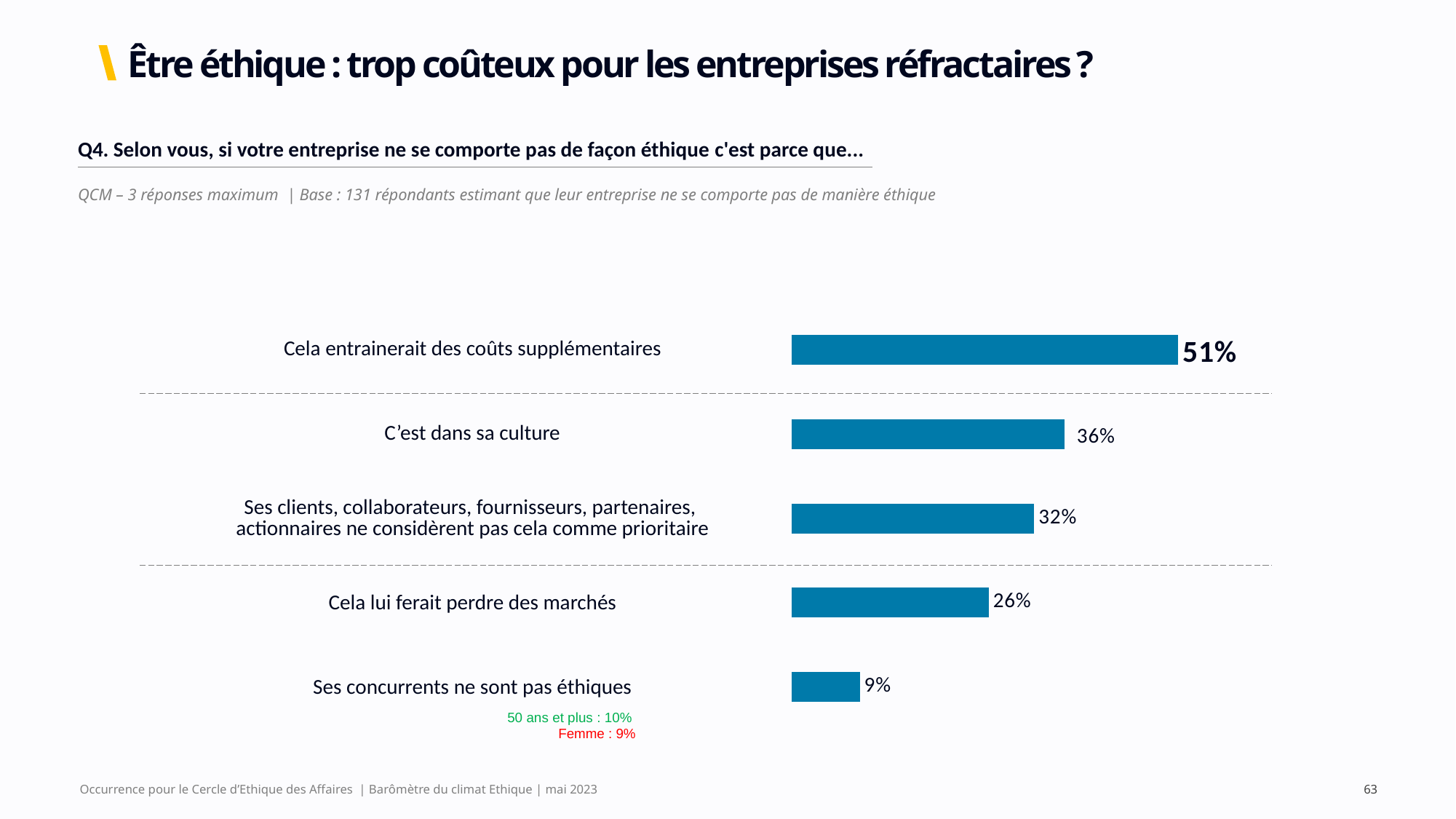
What is the difference between the values for "Cela entrainerait des coûts supplémentaires" and "C'est dans sa culture"? 15% Which is larger: the value for "C'est dans sa culture" or the value for "Ses clients, collaborateurs, fournisseurs, partenaires, actionnaires ne considèrent pas cela comme prioritaire"? C'est dans sa culture What is the value for "Ses concurrents ne sont pas éthiques"? 9% What is the base (number of respondents) stated for the chart? 131 répondants What kind of chart is shown on the slide? Bar chart Which category has the lowest value? Ses concurrents ne sont pas éthiques Which category has the highest value? Cela entrainerait des coûts supplémentaires What is the value for "Cela entrainerait des coûts supplémentaires"? 51% What is the value for "Cela lui ferait perdre des marchés"? 26% What is the value for "C'est dans sa culture"? 36% What is the difference between the values for "Cela lui ferait perdre des marchés" and "Ses concurrents ne sont pas éthiques"? 17% How many categories are shown in the chart? 5